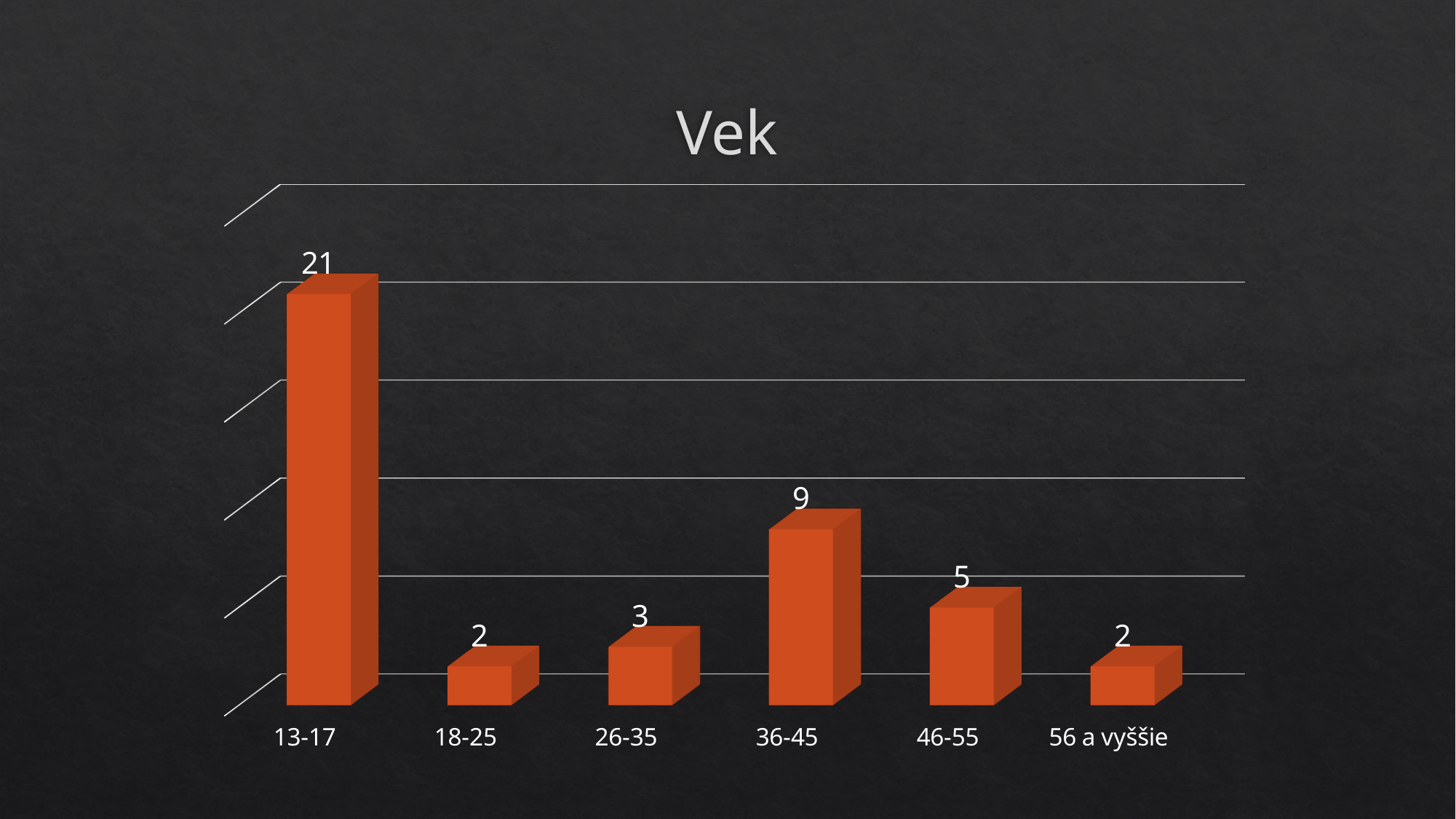
Which age group has the highest value? 13-17 What kind of chart is shown on the slide? bar chart What colour are the bars in the chart? orange What is the value for the 36-45 age group? 9 How many age groups are shown on the chart? 6 What is the difference between the values for 46-55 and 18-25? 3 What is the difference between the values for 13-17 and 36-45? 12 What is the value for the 26-35 age group? 3 What is the value for the 13-17 age group? 21 Which is larger, the value for 36-45 or the value for 46-55? 36-45 What is the value for the 46-55 age group? 5 What is the title of the chart? Vek